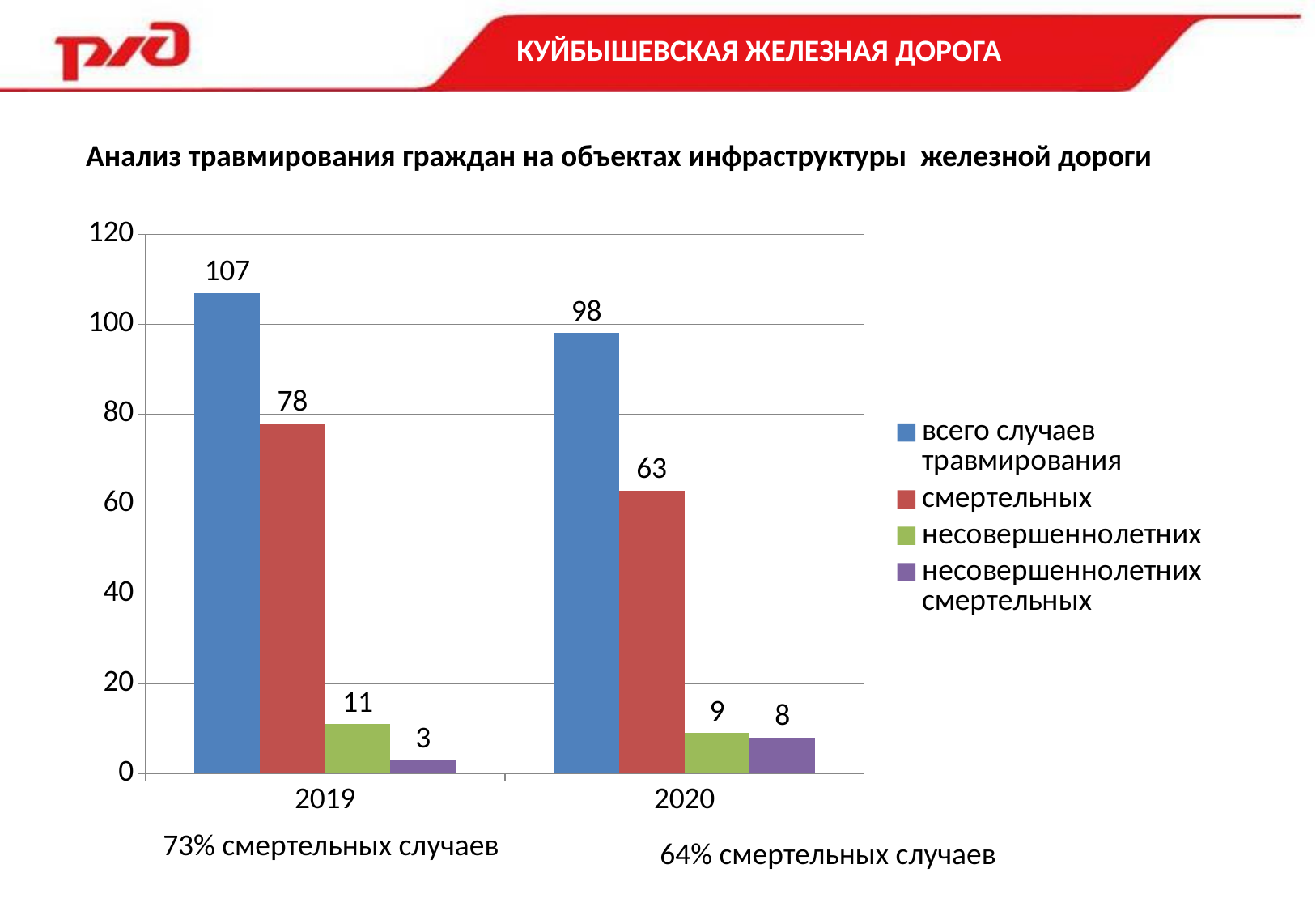
What kind of chart is shown on the slide? bar chart What is the value for 'несовершеннолетних смертельных' in 2019? 3 Does the value for 'всего случаев травмирования' rise or fall from 2019 to 2020? fall How many categories are shown on the x axis? 2 What is the value for 'смертельных' in 2020? 63 What is the value for 'несовершеннолетних' in 2020? 9 How many series does the legend list? 4 Which series has the lowest value in 2019? несовершеннолетних смертельных Which year has the higher value for 'всего случаев травмирования'? 2019 What is the difference between the 'смертельных' values for 2019 and 2020? 15 What is the value for 'всего случаев травмирования' in 2019? 107 What is the difference between 'всего случаев травмирования' and 'смертельных' in 2020? 35